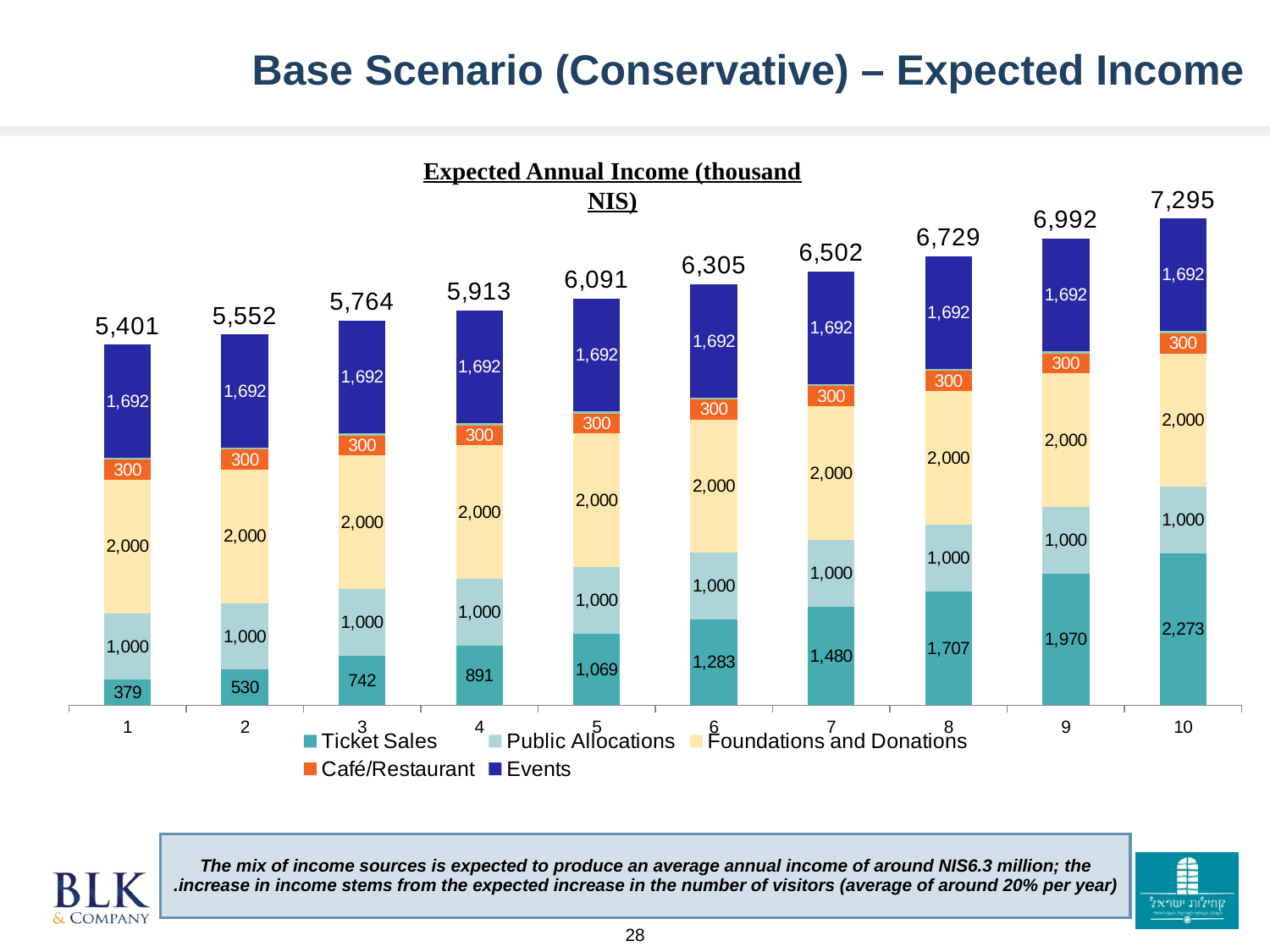
Which year has the highest total expected annual income? 10 What is the total expected annual income in year 10? 7,295 Do the total expected annual income values rise or fall from year 1 to year 10? Rise What type of chart is shown on the slide? Stacked bar chart How many years (categories) are shown on the x axis? 10 What is the total expected annual income in year 1? 5,401 What is the difference between the Ticket Sales values in year 10 and year 1? 1,894 Which year has the lowest Ticket Sales value? 1 What is the Events value in year 3? 1,692 How many series does the legend list? 5 What is the title of the chart? Expected Annual Income (thousand NIS) What is the Ticket Sales value in year 5? 1,069